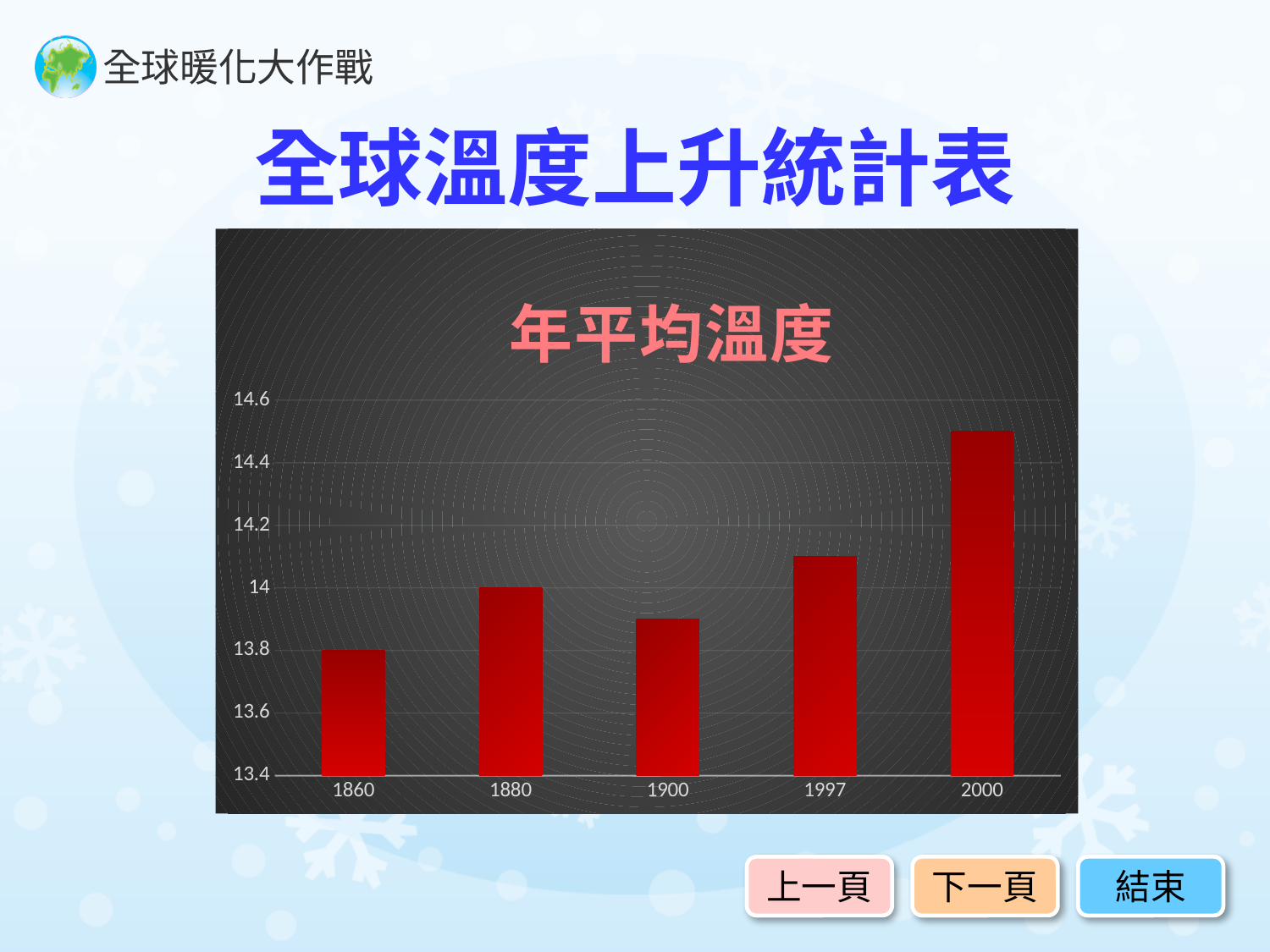
Is the value for 1900 greater or less than 14? less Which year has the lowest bar in the chart? 1860 What is the value for 1860 in the chart? 13.8 What kind of chart is shown on the slide? bar chart What is the title of the chart? 年平均溫度 Is the value for 1997 greater or less than 14? greater Is the value for 2000 greater or less than 14.4? greater Which is larger, the value for 1880 or the value for 1900? 1880 Which year has the highest bar in the chart? 2000 What colour are the bars in the chart? red What is the value for 1880 in the chart? 14 How many years are shown on the x axis of the chart? 5